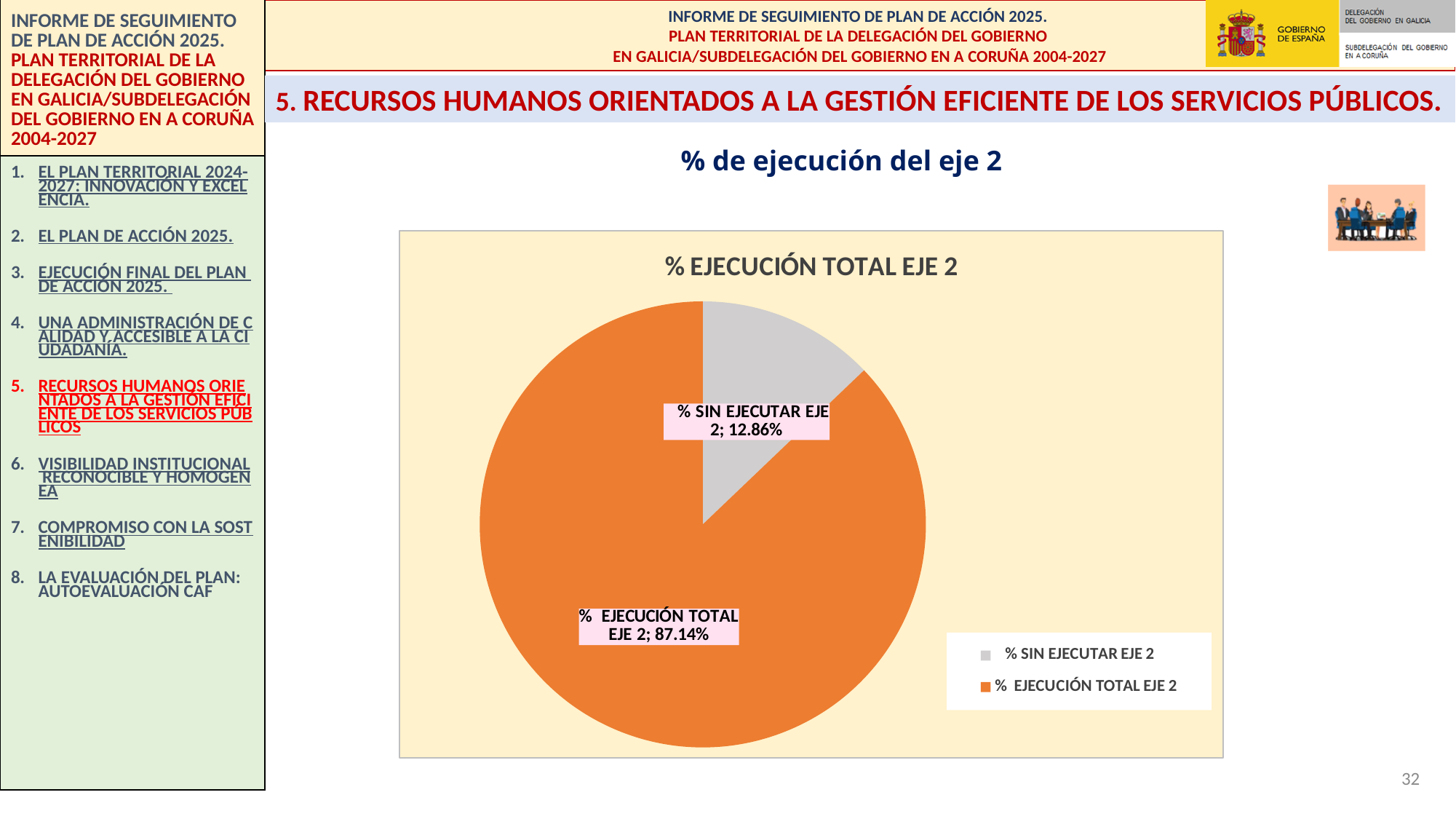
What colour is the % SIN EJECUTAR EJE 2 slice? grey Which is larger, % SIN EJECUTAR EJE 2 or % EJECUCIÓN TOTAL EJE 2? % EJECUCIÓN TOTAL EJE 2 What share of the pie does the % SIN EJECUTAR EJE 2 slice represent? 12.86% Which slice is the largest in the pie chart? % EJECUCIÓN TOTAL EJE 2 How many slices does the pie chart have? 2 How many entries does the legend list? 2 What type of chart is shown on the slide? pie chart What is the value for % SIN EJECUTAR EJE 2? 12.86% What is the value for % EJECUCIÓN TOTAL EJE 2? 87.14% What is the difference between the % EJECUCIÓN TOTAL EJE 2 slice and the % SIN EJECUTAR EJE 2 slice? 74.28% Which slice is the smallest in the pie chart? % SIN EJECUTAR EJE 2 What is the title of the chart? % EJECUCIÓN TOTAL EJE 2